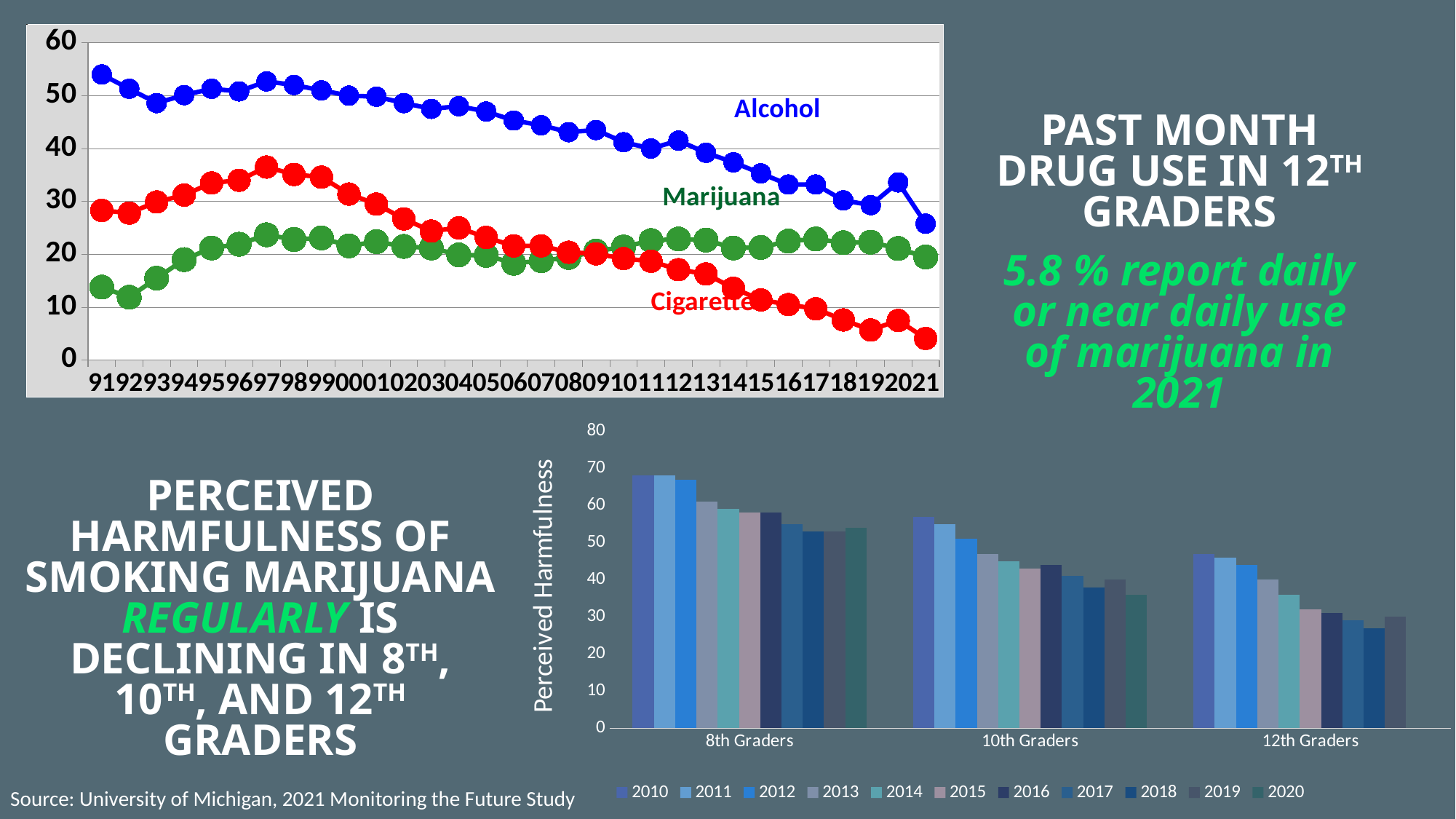
In the bottom-right Perceived Harmfulness chart, is the 2010 value for 8th Graders greater or less than 60? greater What kind of chart is the top-left chart showing past month drug use in 12th graders? line chart How many grade categories are shown on the x axis of the bottom-right Perceived Harmfulness chart? 3 In the top-left line chart, does the Alcohol line rise or fall from 1991 to 2021? fall In the top-left line chart, is the Alcohol value for 2021 greater or less than 30? less How many series does the legend of the bottom-right Perceived Harmfulness chart list? 11 In the top-left line chart, is the Alcohol value for 1991 greater or less than 50? greater In the top-left line chart, which series has the lowest value in 2021? Cigarette In the top-left line chart, which series has the highest values across all years? Alcohol What kind of chart is the bottom-right Perceived Harmfulness chart? bar chart In the top-left line chart, which is larger in 2021, Marijuana or Cigarette? Marijuana